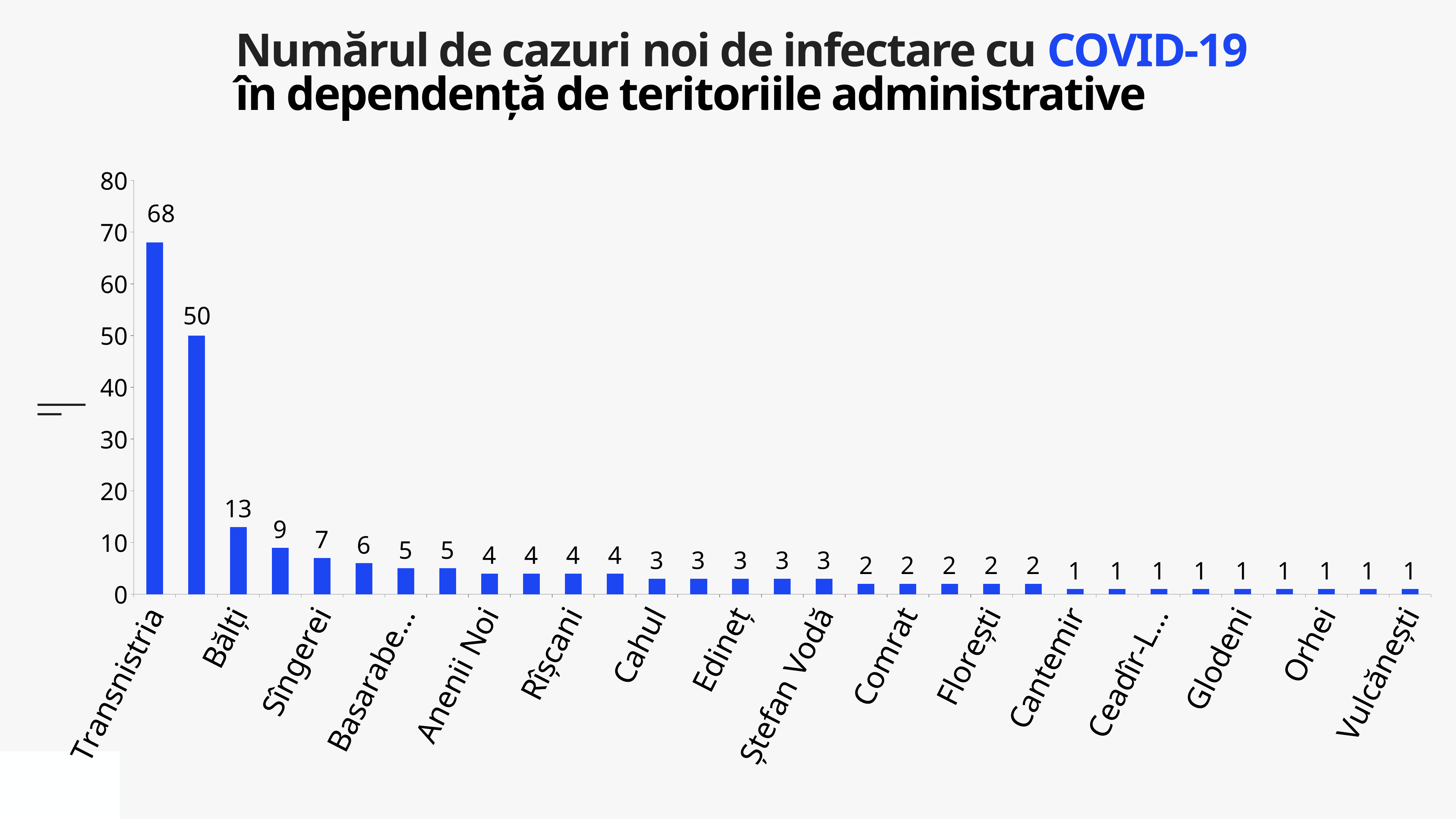
Which territory has the highest number of new cases? Transnistria Which has a larger value, Sîngerei or Cahul? Sîngerei What is the value shown for Comrat? 2 Is the value for Transnistria greater or less than 60? greater What is the value shown for Cahul? 3 What type of chart is shown on the slide? bar chart What is the difference between the values for Transnistria and Bălți? 55 How many new COVID-19 cases are shown for Transnistria? 68 What is the value shown for Sîngerei? 7 How many bars are plotted in the chart? 31 What is the value shown for Bălți? 13 Do the values rise or fall from left to right along the x axis? fall